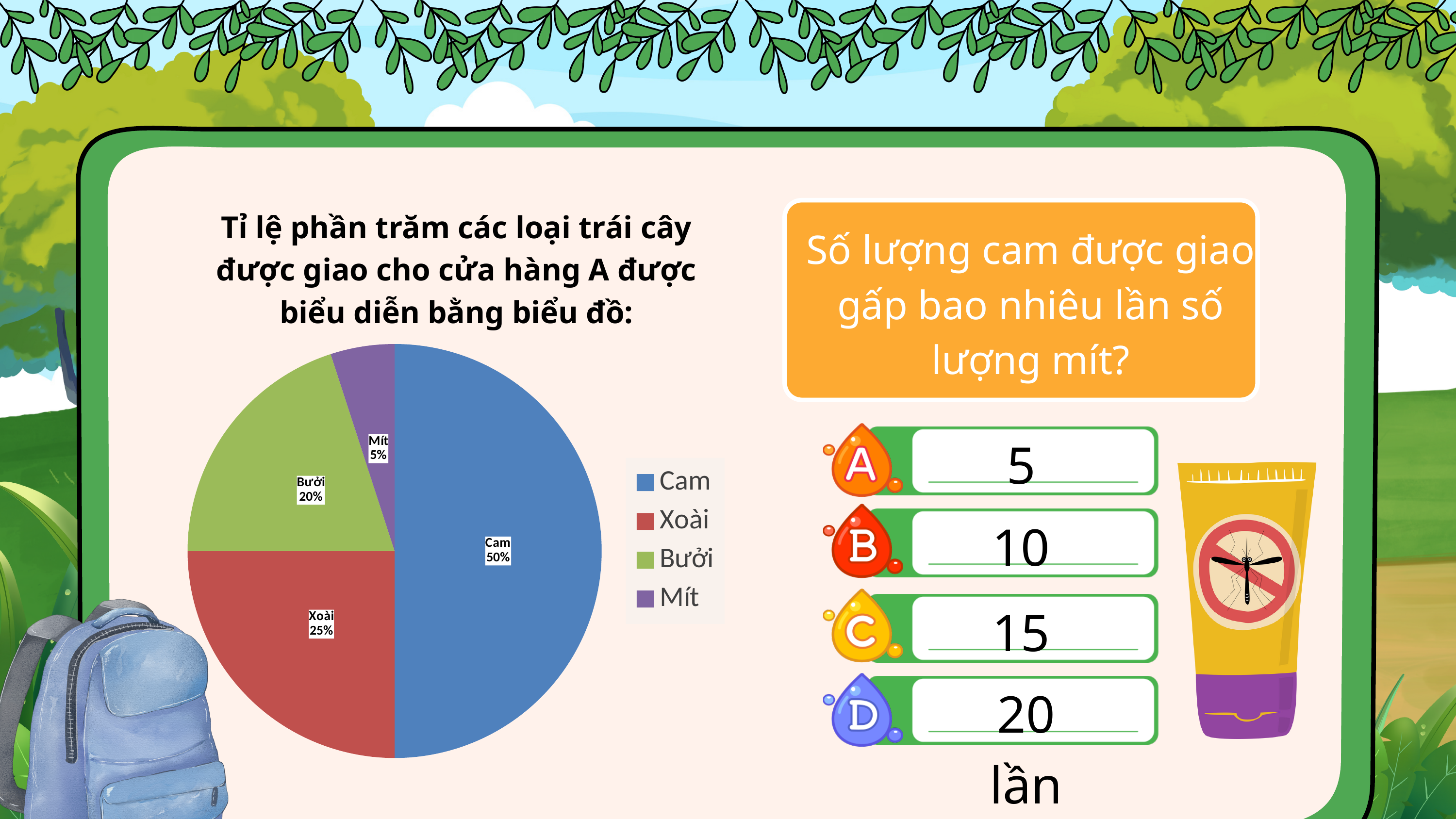
What colour is the Bưởi slice in the pie chart? green What kind of chart is shown on the slide? pie chart What percentage of the pie chart is Bưởi? 20% What percentage of the pie chart is Xoài? 25% How many slices does the pie chart have? 4 How many entries does the legend list? 4 Which is larger, the share for Bưởi or the share for Xoài? Xoài What percentage of the pie chart is Mít? 5% Which fruit has the largest share of the pie chart? Cam What percentage of the pie chart is Cam? 50% Which fruit has the smallest share of the pie chart? Mít What is the difference in percentage points between Cam and Xoài? 25